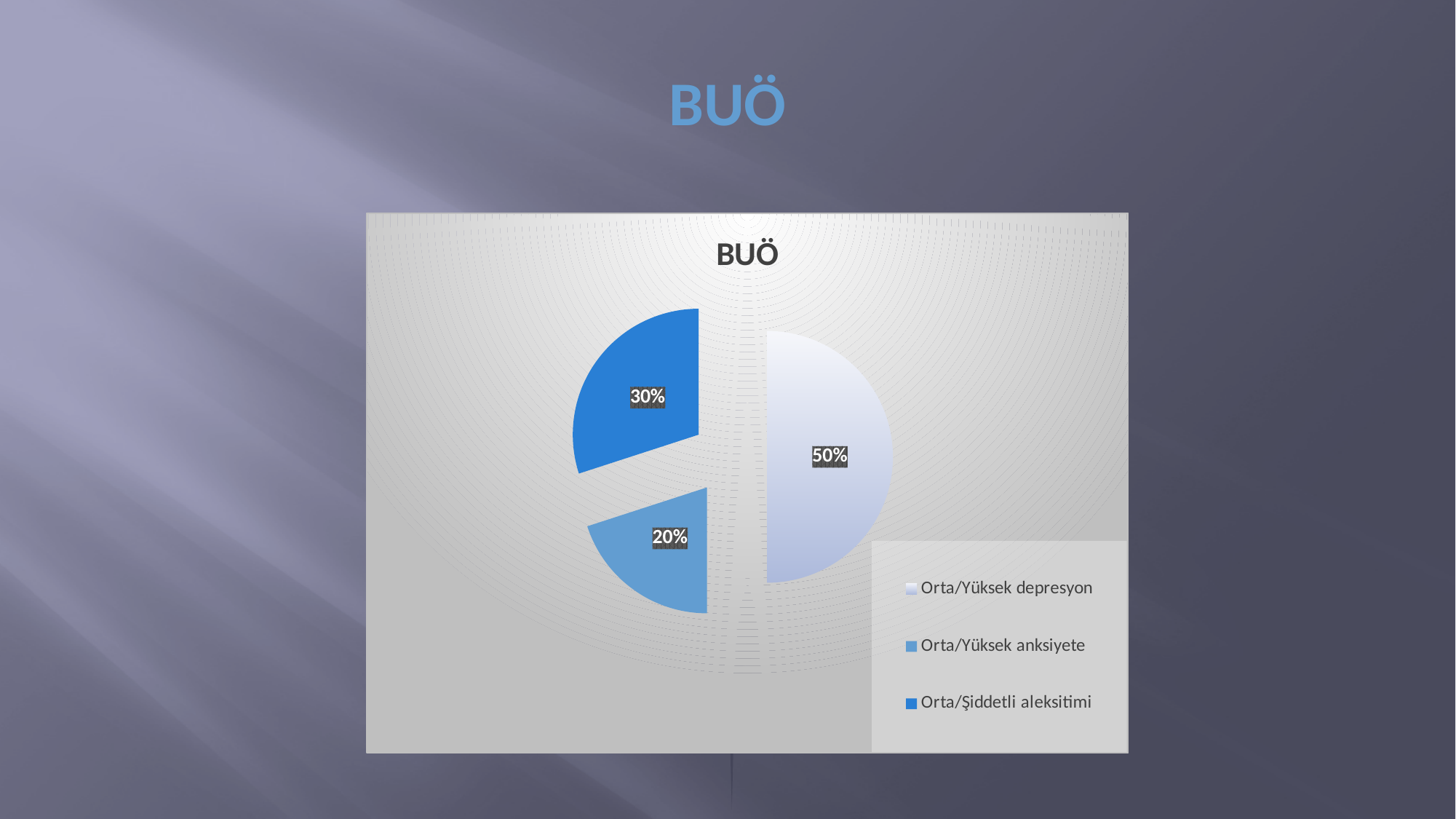
What share of the pie is Orta/Şiddetli aleksitimi? 30% What share of the pie is Orta/Yüksek depresyon? 50% Which legend entry is shown in the darkest blue? Orta/Şiddetli aleksitimi How many entries does the legend list? 3 How many slices does the pie chart have? 3 Which is larger, the slice for Orta/Şiddetli aleksitimi or the slice for Orta/Yüksek anksiyete? Orta/Şiddetli aleksitimi What is the chart's title? BUÖ Which category has the smallest slice of the pie? Orta/Yüksek anksiyete Which category has the largest slice of the pie? Orta/Yüksek depresyon What is the difference in percentage points between Orta/Yüksek depresyon and Orta/Şiddetli aleksitimi? 20% What share of the pie is Orta/Yüksek anksiyete? 20% What kind of chart is shown on the slide? pie chart